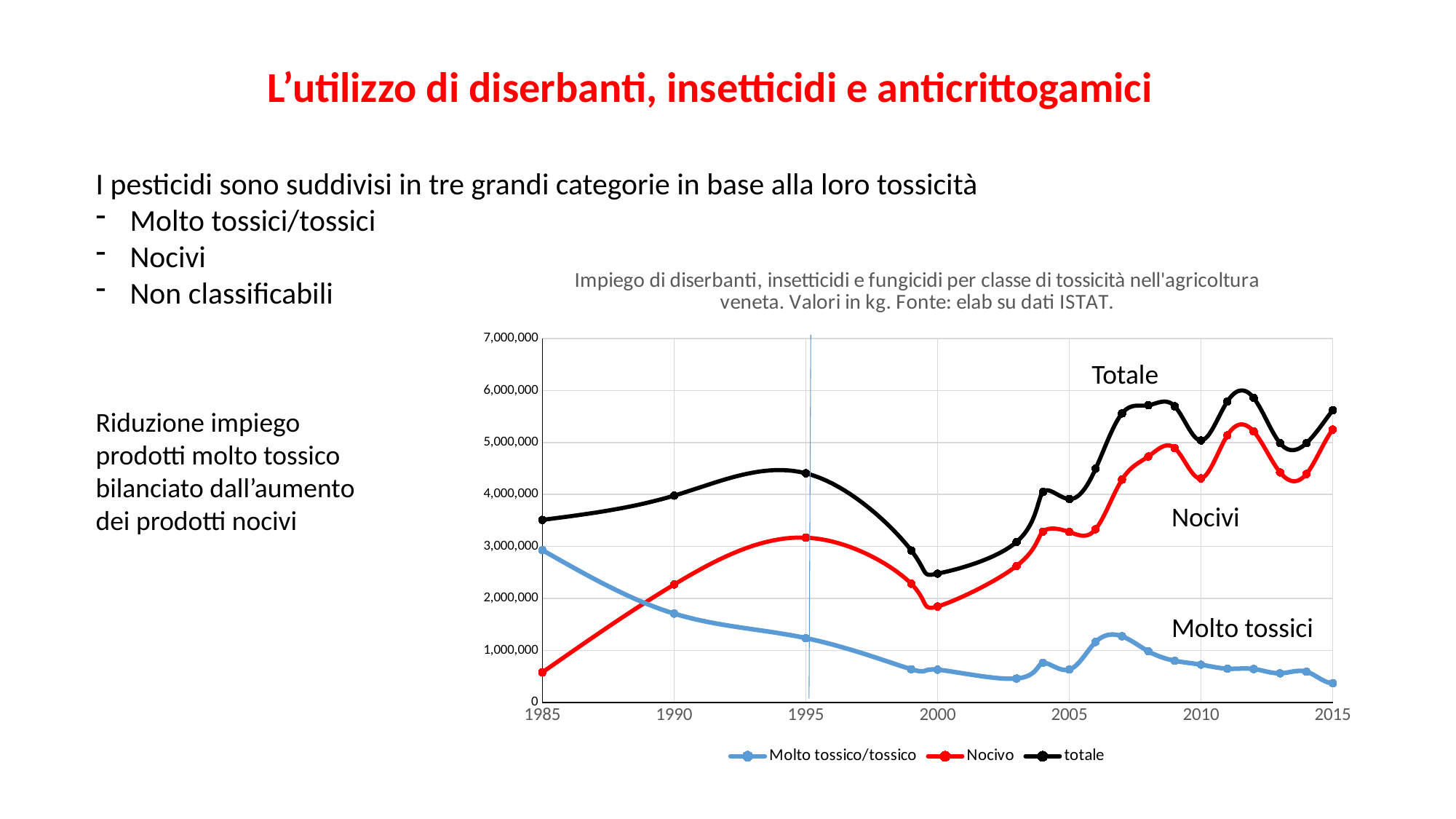
Is the value for totale in 2015 greater or less than 5,000,000? greater What kind of chart is shown on the slide? line chart How many series does the chart legend list? 3 Is the value for Molto tossico/tossico in 1985 greater or less than 2,000,000? greater Which series is drawn in red in the chart? Nocivo Is the value for totale in 2000 greater or less than 3,000,000? less In 2015, which series has the larger value: Nocivo or Molto tossico/tossico? Nocivo In 1985, which series has the larger value: Molto tossico/tossico or Nocivo? Molto tossico/tossico Does the Molto tossico/tossico series rise or fall between 1985 and 1995? fall Which series is drawn in blue in the chart? Molto tossico/tossico